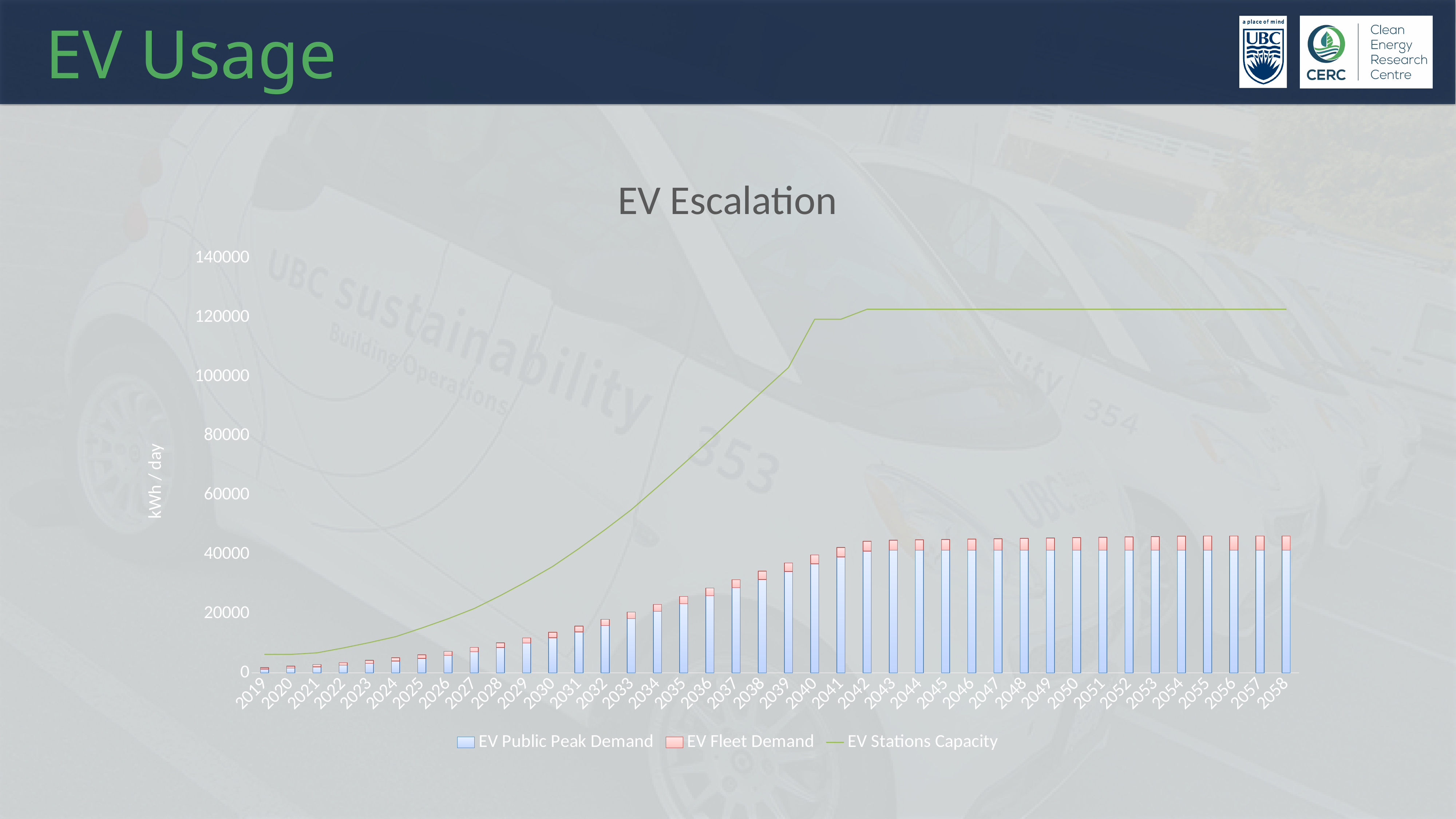
What kind of chart is the EV Escalation chart? Combined stacked bar and line chart What is the title of the chart on the slide? EV Escalation Is the total stacked bar for 2030 greater or less than 20000? less Does the EV Stations Capacity line rise or fall from 2019 to 2042? rise Is the EV Stations Capacity value for 2036 greater or less than 60000? greater In 2030, which is larger: the EV Stations Capacity or the total stacked demand bar? EV Stations Capacity What is the label on the vertical axis of the EV Escalation chart? kWh / day Is the EV Stations Capacity value for 2050 greater or less than 100000? greater How many years are shown along the x axis of the EV Escalation chart? 40 How many series does the legend of the EV Escalation chart list? 3